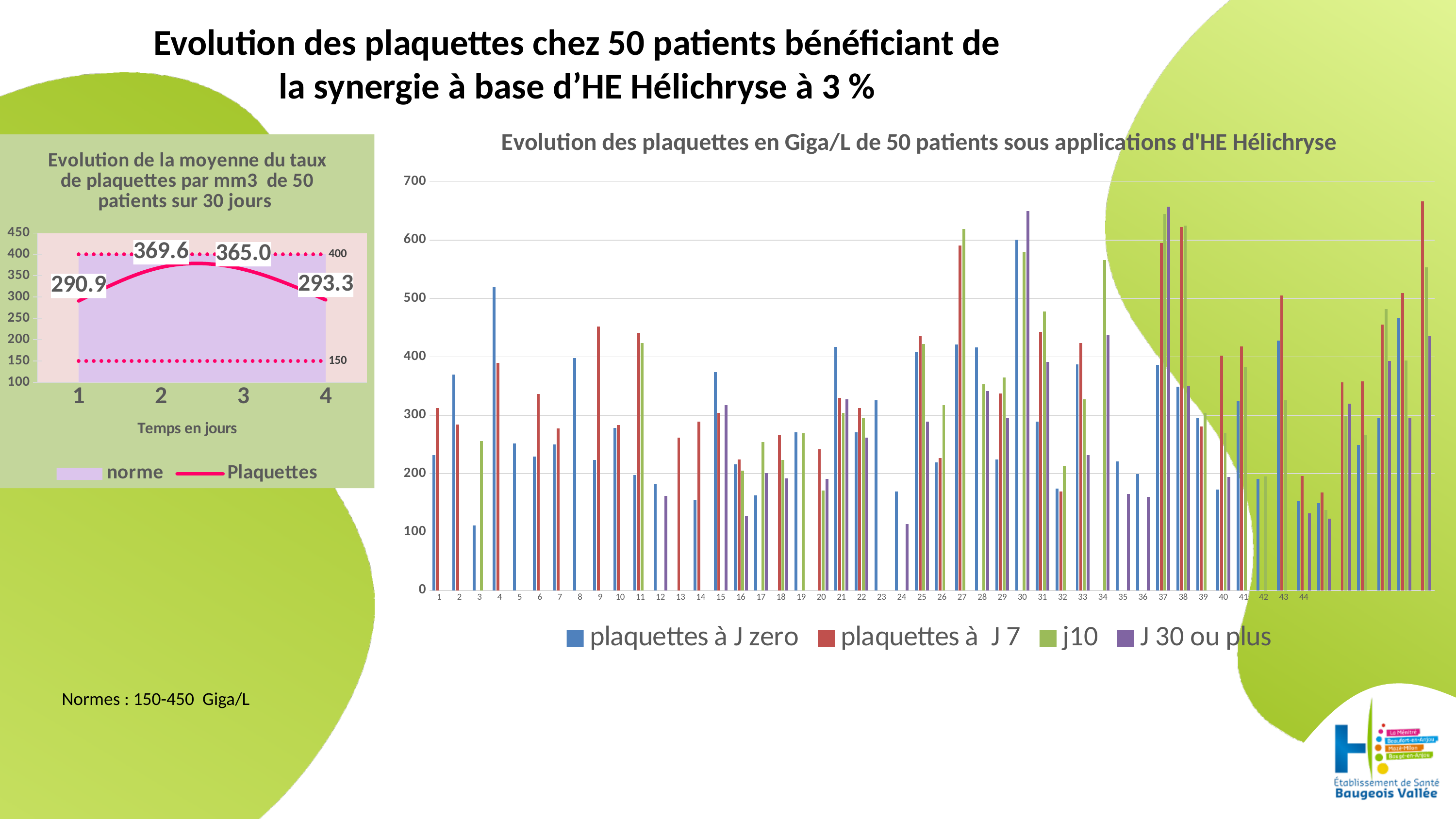
On the right chart 'Evolution des plaquettes en Giga/L de 50 patients sous applications d'HE Hélichryse', how many series does the legend list? 4 On the left chart 'Evolution de la moyenne du taux de plaquettes', at which day is the Plaquettes value highest? 2 What kind of chart is the right chart 'Evolution des plaquettes en Giga/L de 50 patients sous applications d'HE Hélichryse'? bar chart On the left chart 'Evolution de la moyenne du taux de plaquettes', what is the value of Plaquettes at day 2? 369.6 On the left chart 'Evolution de la moyenne du taux de plaquettes', how many entries does the legend list? 2 On the left chart 'Evolution de la moyenne du taux de plaquettes', how many data points are plotted on the Plaquettes line? 4 On the left chart 'Evolution de la moyenne du taux de plaquettes', what is the value of Plaquettes at day 1? 290.9 On the left chart 'Evolution de la moyenne du taux de plaquettes', at which day is the Plaquettes value lowest? 1 On the right chart 'Evolution des plaquettes en Giga/L de 50 patients sous applications d'HE Hélichryse', is the 'plaquettes à J zero' value for patient 4 greater or less than 500? greater On the left chart 'Evolution de la moyenne du taux de plaquettes', what is the value of Plaquettes at day 4? 293.3 On the left chart 'Evolution de la moyenne du taux de plaquettes', what is the difference between the Plaquettes values at day 2 and day 3? 4.6 On the right chart 'Evolution des plaquettes en Giga/L de 50 patients sous applications d'HE Hélichryse', for patient 9, which is larger: 'plaquettes à J zero' or 'plaquettes à J 7'? plaquettes à J 7